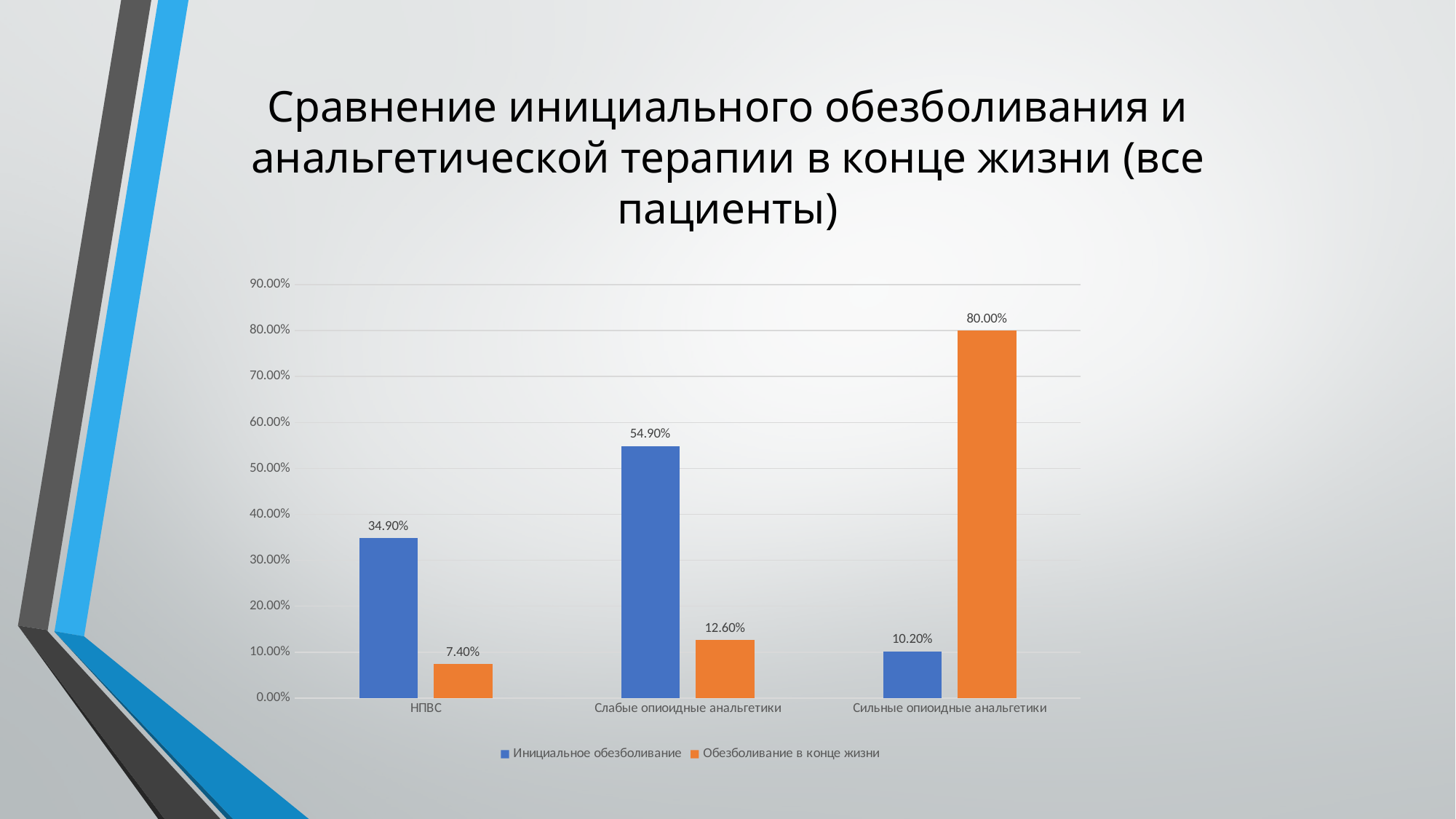
What is the difference between the Инициальное обезболивание and Обезболивание в конце жизни values for Слабые опиоидные анальгетики? 42.30% Is the value for НПВС in the Инициальное обезболивание series greater or less than 30.00%? greater Which category has the lowest value in the Обезболивание в конце жизни series? НПВС What is the value for Сильные опиоидные анальгетики in the Обезболивание в конце жизни series? 80.00% Which is larger for Сильные опиоидные анальгетики: Инициальное обезболивание or Обезболивание в конце жизни? Обезболивание в конце жизни What is the value for НПВС in the Инициальное обезболивание series? 34.90% What is the value for Слабые опиоидные анальгетики in the Обезболивание в конце жизни series? 12.60% Which category has the highest value in the Инициальное обезболивание series? Слабые опиоидные анальгетики How many categories are shown on the x axis? 3 How many series does the legend list? 2 What colour are the bars for the Обезболивание в конце жизни series? Orange What kind of chart is shown on the slide? Bar chart